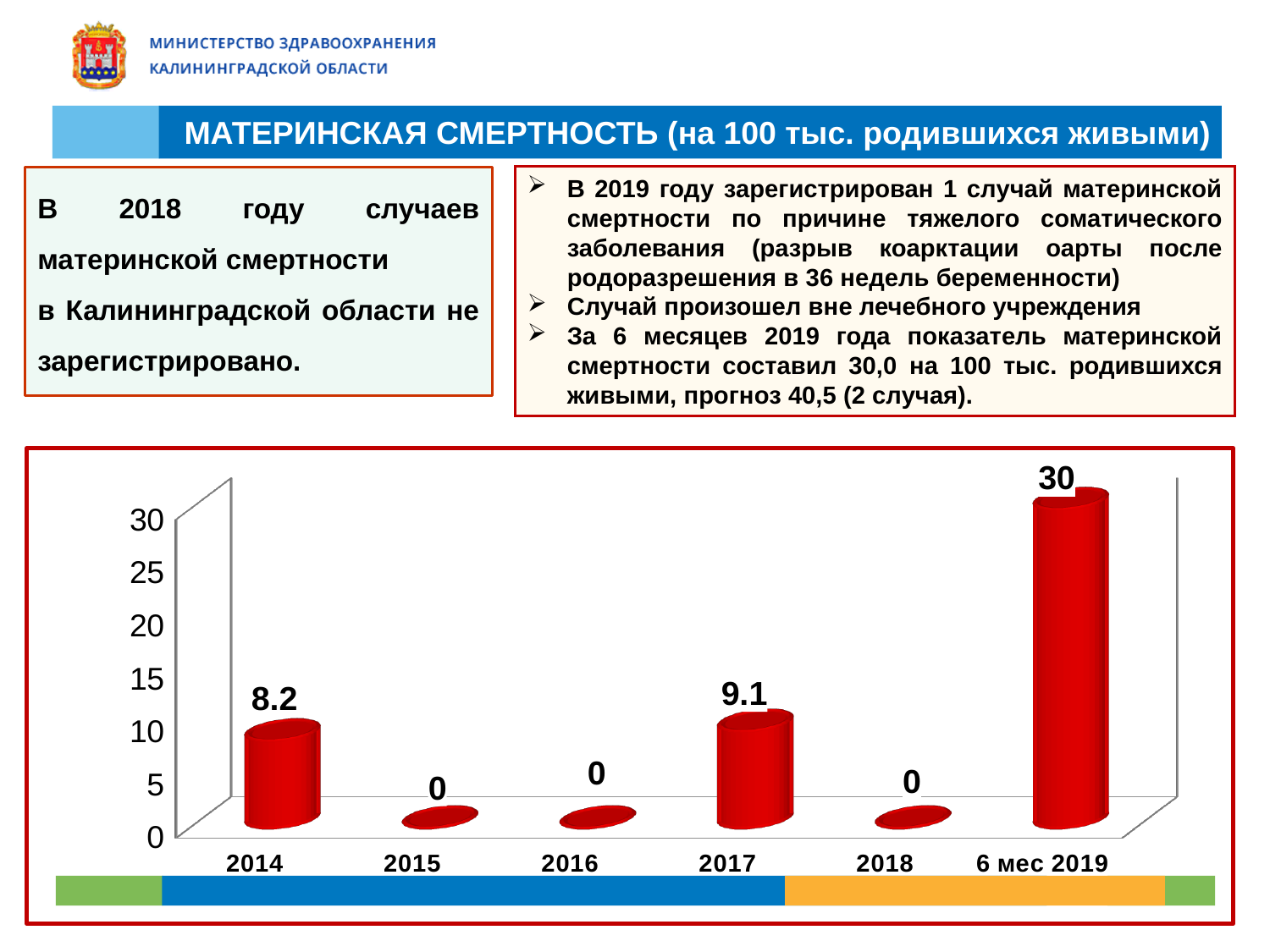
What colour are the bars in the chart? red What is the difference between the values for 6 мес 2019 and 2017? 20.9 What is the value for 2014? 8.2 What is the value for 6 мес 2019? 30 How many categories have a value of 0? 3 What is the difference between the values for 2017 and 2014? 0.9 What kind of chart is shown on the slide? bar chart What is the value for 2018? 0 How many categories are shown on the x axis? 6 Which is larger, the value for 2014 or the value for 2017? 2017 What is the value for 2017? 9.1 Which category has the highest value? 6 мес 2019